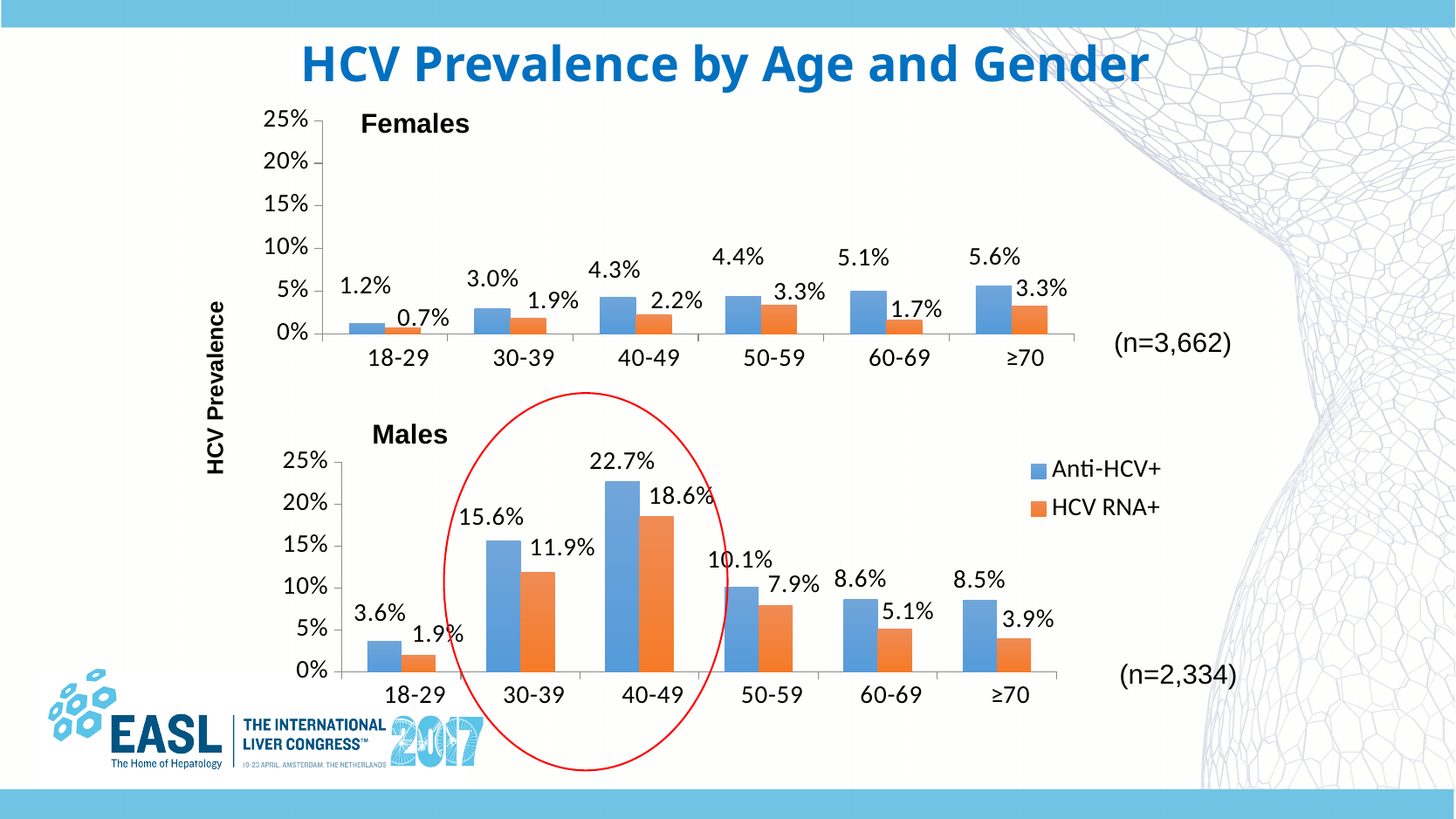
In the Females chart, which age group has the lowest HCV RNA+ value? 18-29 In the Females chart, does the Anti-HCV+ value rise or fall from 18-29 to ≥70? rise In the Males chart, what is the HCV RNA+ value for the 30-39 age group? 11.9% In the Males chart, what is the difference between the Anti-HCV+ and HCV RNA+ values for the 40-49 age group? 4.1% How many age groups are shown on the x axis of the Females chart? 6 What type of chart is the Males chart? bar chart In the Males chart, which age group has the highest Anti-HCV+ value? 40-49 In the Females chart, what is the Anti-HCV+ value for the 40-49 age group? 4.3% In the Males chart, is the Anti-HCV+ value for 30-39 greater or less than 15%? greater What is the sample size (n) shown next to the Males chart? n=2,334 In the Females chart, which is larger: the HCV RNA+ value for 50-59 or for 60-69? 50-59 How many series does the legend list? 2